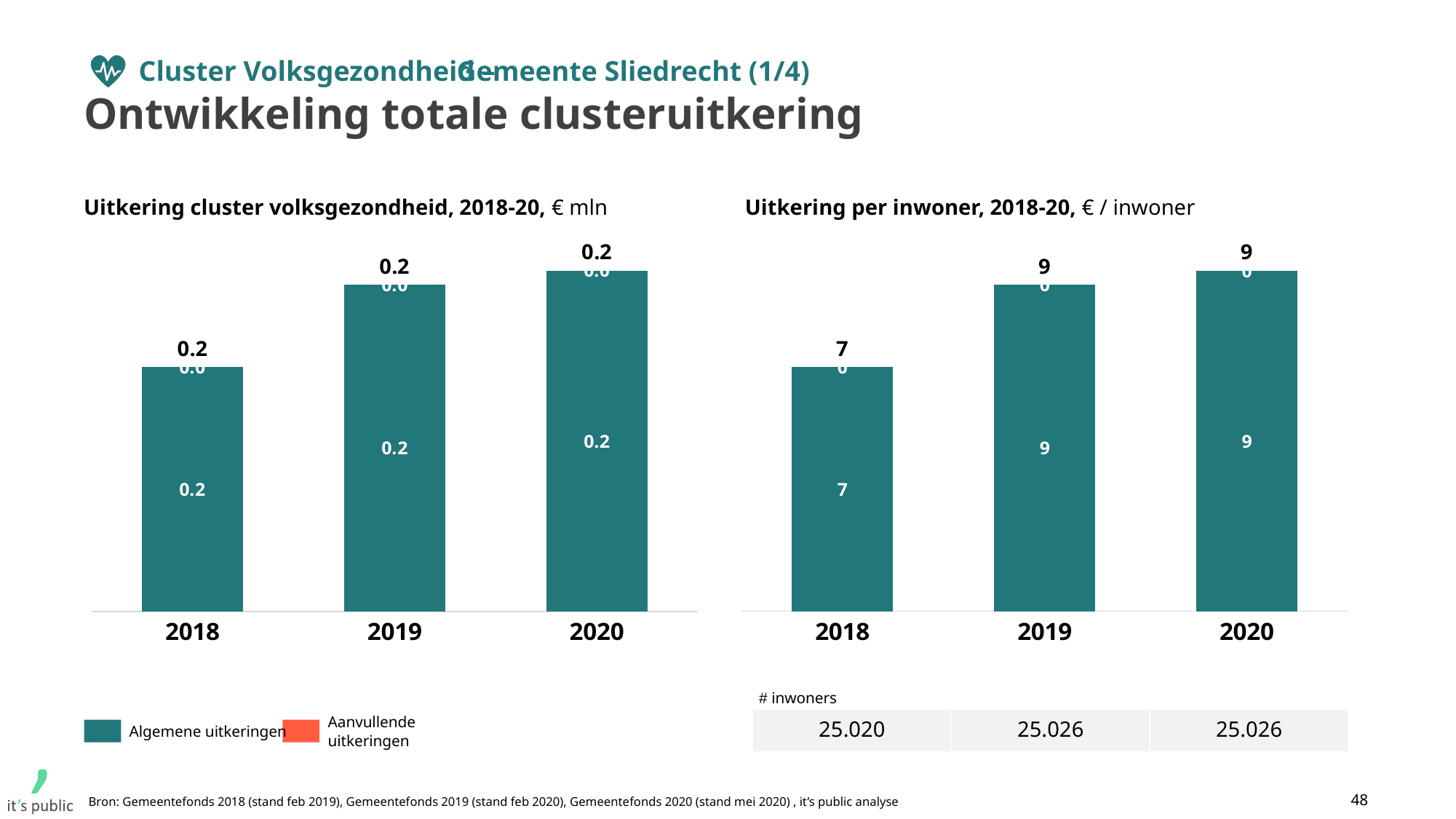
In the chart 'Uitkering cluster volksgezondheid, 2018-20', what is the value of the Algemene uitkeringen segment for 2019? 0.2 In the chart 'Uitkering per inwoner, 2018-20', what is the value for 2018? 7 How many series does the legend of the left chart list? 2 In the chart 'Uitkering per inwoner, 2018-20', do the values rise or fall from 2018 to 2019? Rise What kind of chart is 'Uitkering per inwoner, 2018-20'? Bar chart In the chart 'Uitkering cluster volksgezondheid, 2018-20', what is the total value labelled above the bar for 2020? 0.2 In the chart 'Uitkering per inwoner, 2018-20', what is the value for 2019? 9 In the chart 'Uitkering per inwoner, 2018-20', what is the difference between the values for 2019 and 2018? 2 In the chart 'Uitkering per inwoner, 2018-20', which year has the larger value, 2018 or 2020? 2020 What are the two legend entries shown below the left chart? Algemene uitkeringen and Aanvullende uitkeringen How many years are shown on the x axis of the chart 'Uitkering cluster volksgezondheid, 2018-20'? 3 In the chart 'Uitkering per inwoner, 2018-20', which year has the lowest value? 2018